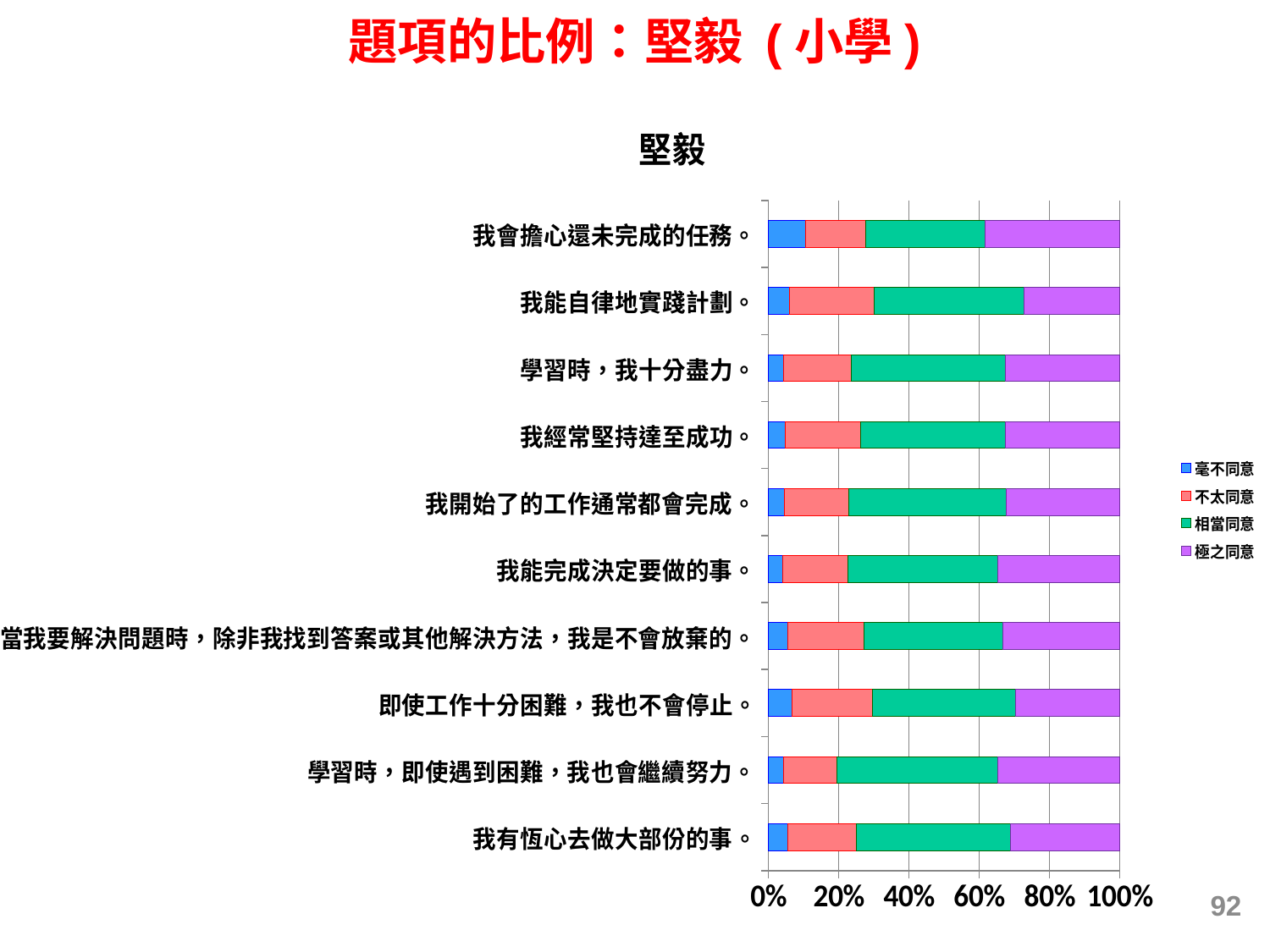
Is the 極之同意 share for 我會擔心還未完成的任務 greater or less than 20%? greater How many series does the legend list? 4 What value does each stacked bar reach at its right end? 100% Which legend entry is shown in purple? 極之同意 For 即使工作十分困難，我也不會停止, does the combined 毫不同意 and 不太同意 portion end above or below 20%? above Is the 毫不同意 segment for 我會擔心還未完成的任務 larger or smaller than the 毫不同意 segment for 學習時，我十分盡力? larger What is the title of the chart? 堅毅 How many survey items (categories) are plotted in the chart? 10 What is the highest tick label shown on the horizontal axis? 100% Which item has the largest 毫不同意 segment? 我會擔心還未完成的任務。 What kind of chart is shown on the slide? Stacked bar chart Is the 毫不同意 share for 我能完成決定要做的事 greater or less than 20%? less